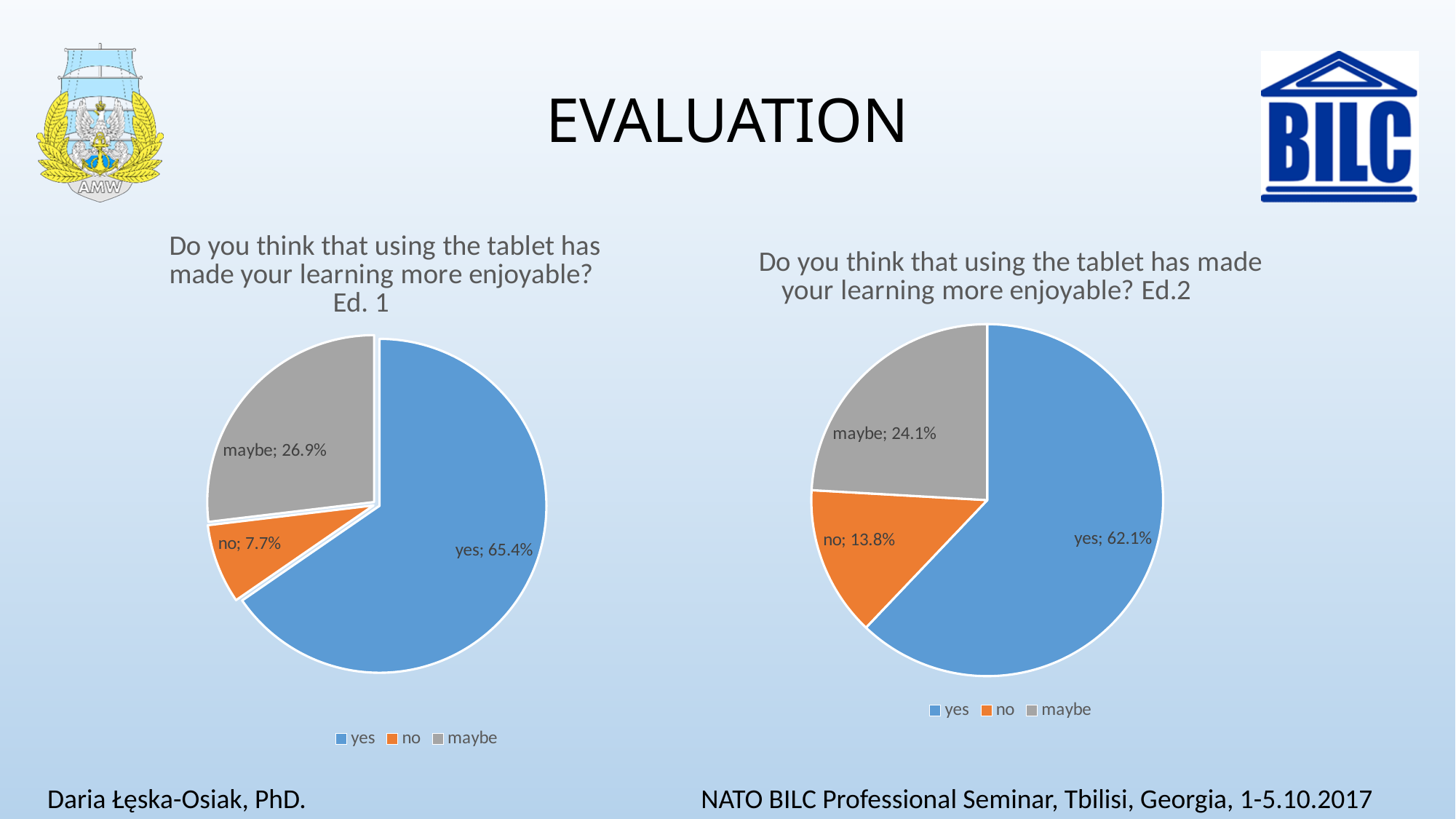
What type of chart is used for the Ed. 1 results on the left? Pie chart In the Ed.2 pie chart on the right, which answer has the smallest share? no In the Ed. 1 pie chart on the left, which answer has the largest share? yes In the Ed.2 pie chart on the right, what colour is the "maybe" slice? Grey How many entries does the legend of the Ed.2 chart on the right list? 3 In the Ed.2 pie chart on the right, what share of respondents answered "maybe"? 24.1% How many slices does the Ed.2 pie chart on the right have? 3 Is the "yes" share larger in the Ed. 1 chart on the left or in the Ed.2 chart on the right? Ed. 1 In the Ed.2 pie chart on the right, what share of respondents answered "no"? 13.8% In the Ed. 1 pie chart on the left, what share of respondents answered "yes"? 65.4% In the Ed. 1 pie chart on the left, what share of respondents answered "no"? 7.7% In the Ed. 1 pie chart on the left, what is the difference between the "maybe" share and the "no" share? 19.2%